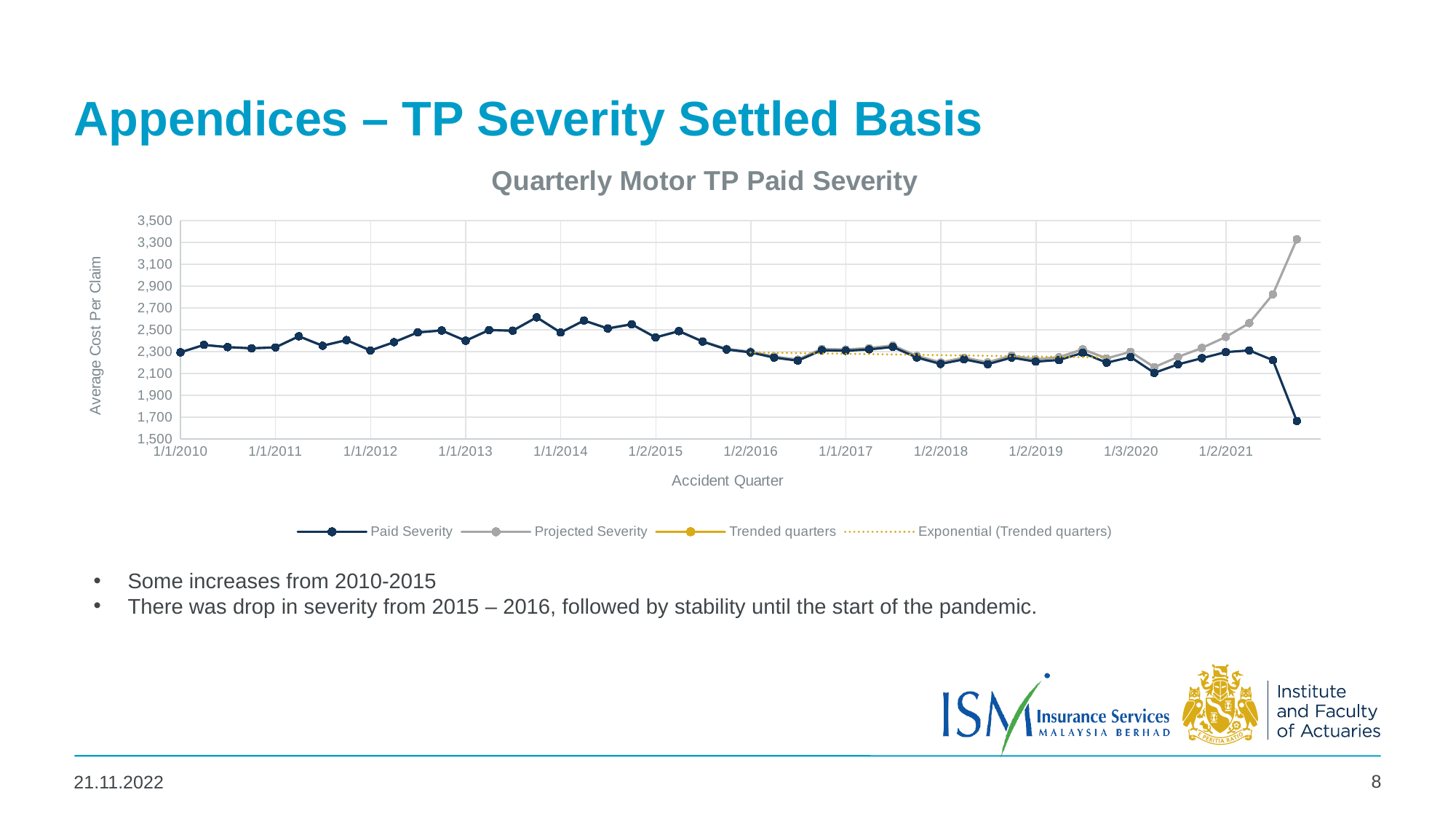
Is the Paid Severity value at 1/1/2011 greater or less than 2,100? greater Which is larger at the last plotted quarter: Paid Severity or Projected Severity? Projected Severity Does the Projected Severity series rise or fall over its final quarters after 1/2/2021? Rise Is the final Projected Severity value (the last grey point on the right) greater or less than 3,100? greater Is the final Paid Severity value (the last dark point on the right) greater or less than 1,900? less What is the title of the chart? Quarterly Motor TP Paid Severity What is the label of the vertical axis? Average Cost Per Claim Which series contains the lowest point on the chart? Paid Severity What kind of chart is shown on the slide? Line chart Which series reaches the highest value on the chart? Projected Severity How many series does the chart legend list? 4